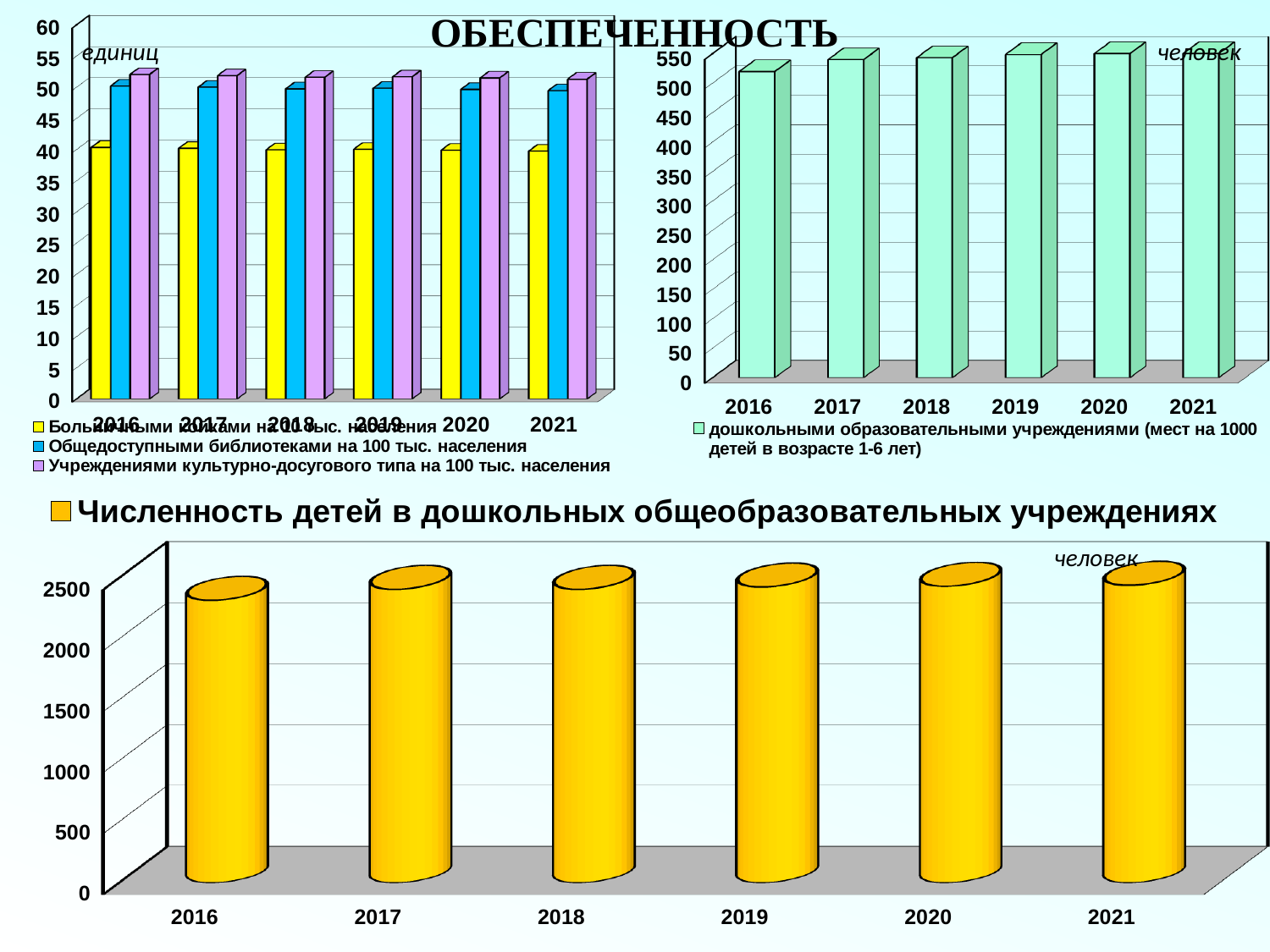
In the top-left chart, is the value for 'Общедоступными библиотеками на 100 тыс. населения' in 2018 greater or less than 45? greater In the bottom chart, is the value for 2016 greater or less than 2000? greater In the top-right chart, is the value for 2016 greater or less than 500? greater How many years are shown on the x axis of the top-left chart? 6 In the top-left chart, which is larger in 2016: 'Больничными койками на 10 тыс. населения' or 'Общедоступными библиотеками на 100 тыс. населения'? Общедоступными библиотеками на 100 тыс. населения What kind of chart is the top-left chart on the slide? bar chart How many series does the legend of the top-left chart list? 3 In the top-right chart, do the values rise or fall from 2016 to 2021? rise How many years are shown on the x axis of the bottom chart? 6 What is the title of the bottom chart? Численность детей в дошкольных общеобразовательных учреждениях